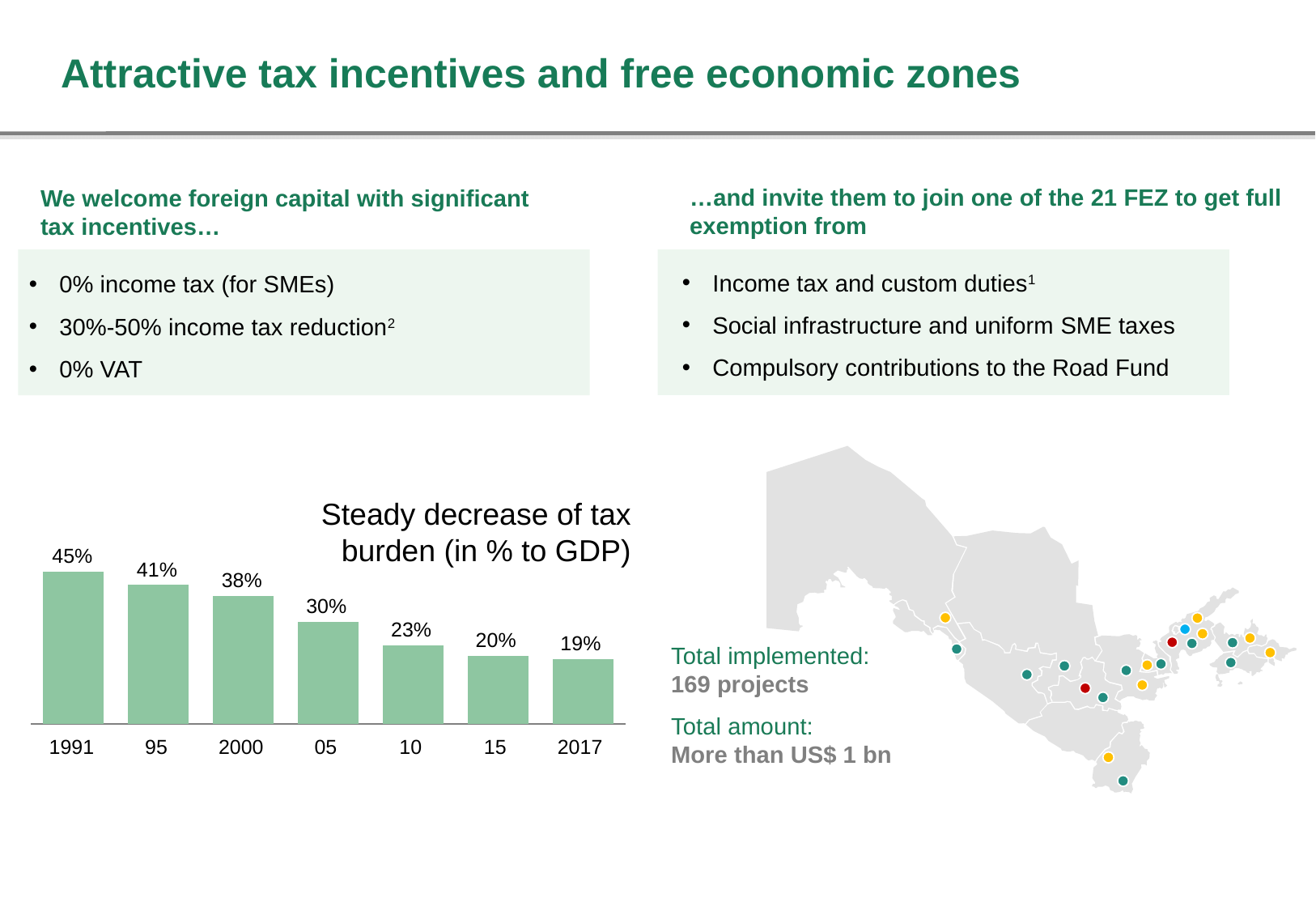
Which is larger, the tax burden in 95 (1995) or in 15 (2015)? 95 (1995) Which year has the highest tax burden in the chart? 1991 Which year has the lowest tax burden in the chart? 2017 What value is shown for 2000 in the tax burden chart? 38% How many years (bars) are shown in the tax burden chart? 7 By how many percentage points did the tax burden fall from 1991 to 2017? 26 percentage points What value is shown for 10 (2010) in the tax burden chart? 23% What is the tax burden (in % to GDP) shown for 2017? 19% What is the tax burden (in % to GDP) shown for 1991? 45% What is the difference between the tax burden in 2000 and in 05 (2005)? 8 percentage points What type of chart is used to show the tax burden in % to GDP? Bar chart Does the tax burden rise or fall from 1991 to 2017 in the chart? Fall